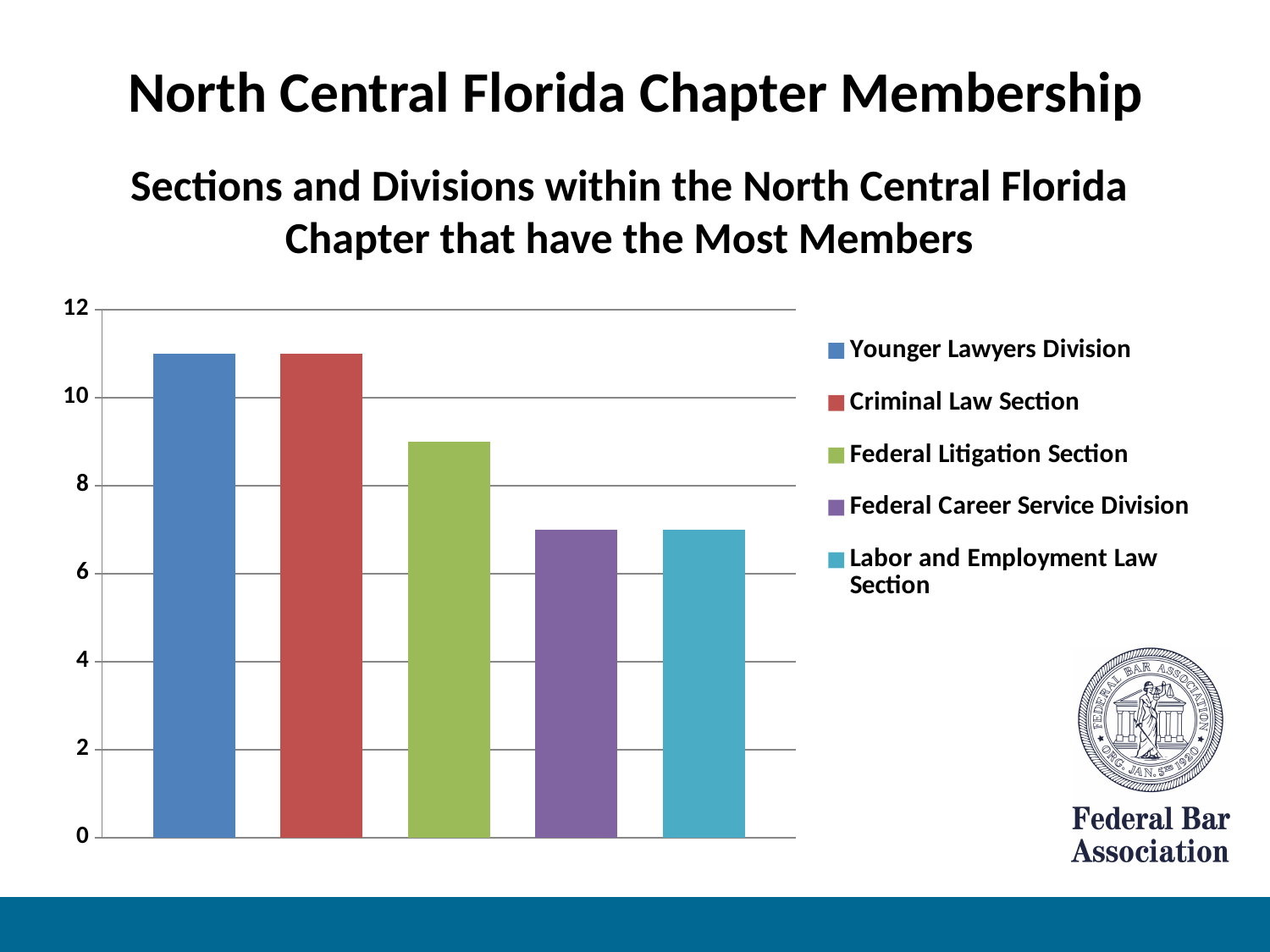
Is the value for Federal Litigation Section greater or less than 8? greater Is the value for Criminal Law Section greater or less than 12? less How many entries does the legend list? 5 Is the value for Younger Lawyers Division greater or less than 10? greater Which is larger, the value for Federal Litigation Section or the value for Federal Career Service Division? Federal Litigation Section Which is larger, the value for Criminal Law Section or the value for Labor and Employment Law Section? Criminal Law Section Do the bar values generally rise or fall from left to right across the chart? fall What colour is the bar for Federal Litigation Section? green What kind of chart is shown on the slide? bar chart How many bars are plotted in the chart? 5